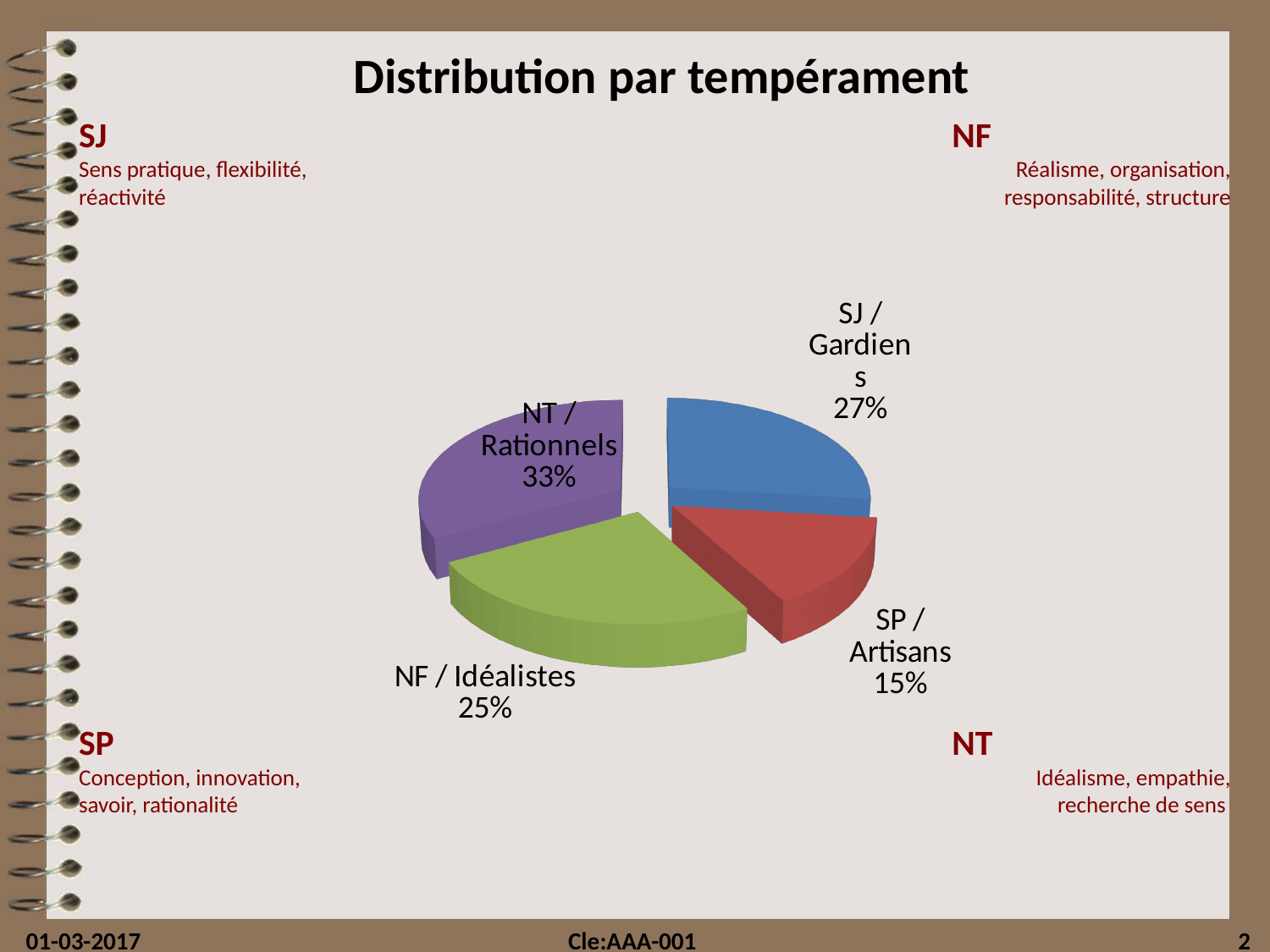
What is the difference in percentage points between NT / Rationnels and SP / Artisans? 18 How many slices does the pie chart have? 4 What percentage is shown for SP / Artisans? 15% What type of chart is shown on the slide? pie chart What percentage is shown for SJ / Gardiens? 27% What percentage is shown for NF / Idéalistes? 25% What percentage is shown for NT / Rationnels? 33% What colour is the slice for NF / Idéalistes? green Which category has the largest share of the pie? NT / Rationnels Which is larger, the share for SJ / Gardiens or the share for NF / Idéalistes? SJ / Gardiens Which category has the smallest share of the pie? SP / Artisans What is the title of the chart? Distribution par tempérament